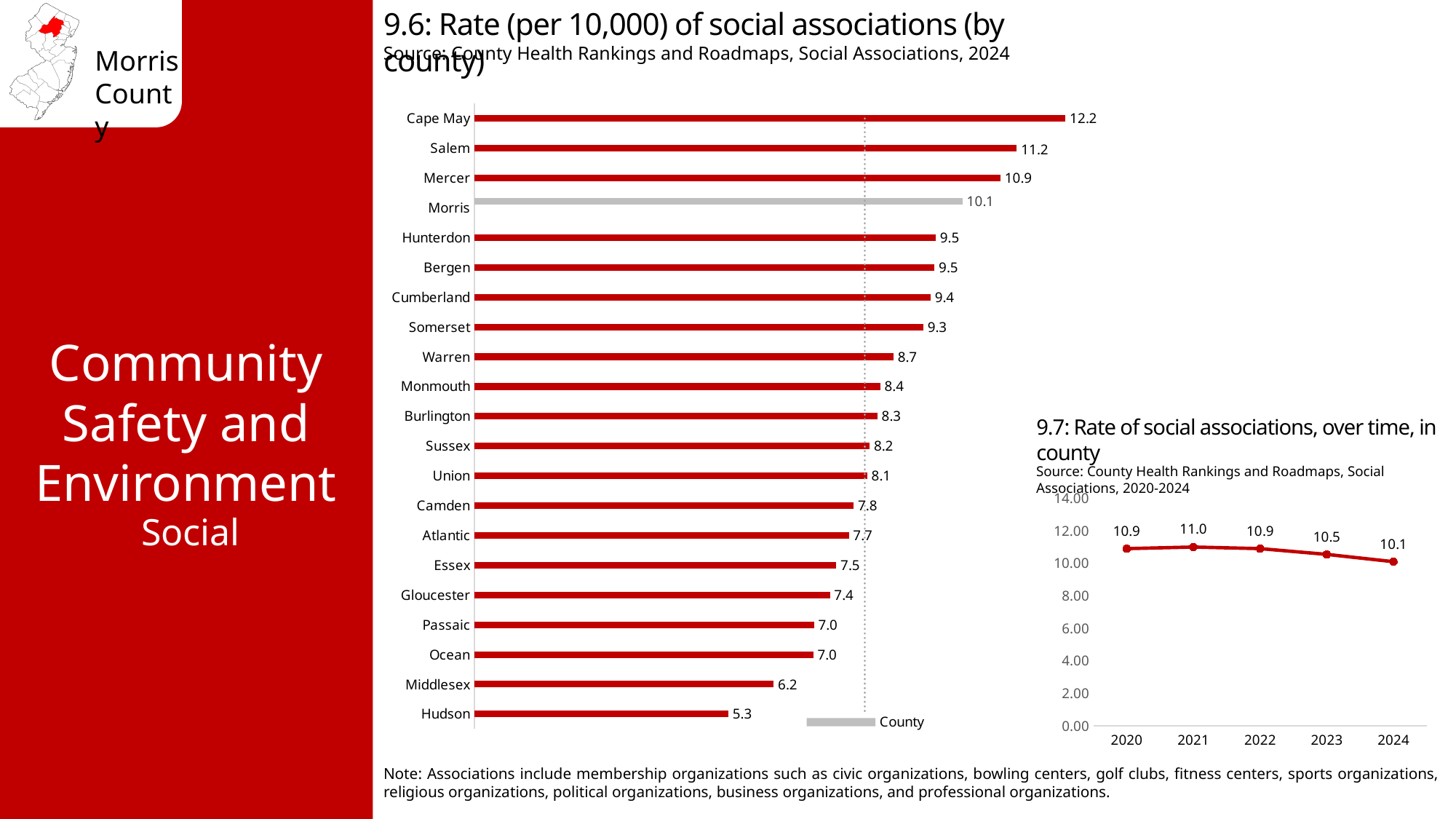
In the chart 9.7 (rate of social associations over time), how many years are plotted? 5 In the chart 9.6 (rate of social associations by county), what is the difference between Cape May and Hudson? 6.9 What kind of chart is chart 9.6 (rate of social associations by county)? Bar chart In the chart 9.6 (rate of social associations by county), how many counties are shown? 21 In the chart 9.6 (rate of social associations by county), what is the value for Middlesex? 6.2 In the chart 9.6 (rate of social associations by county), what is the value for Morris? 10.1 In the chart 9.7 (rate of social associations over time), do the values rise or fall from 2022 to 2024? Fall In the chart 9.6 (rate of social associations by county), which county has the highest rate? Cape May In the chart 9.6 (rate of social associations by county), which has a higher rate, Salem or Mercer? Salem In the chart 9.7 (rate of social associations over time), what is the value for 2021? 11.0 In the chart 9.6 (rate of social associations by county), which county has the lowest rate? Hudson In the chart 9.7 (rate of social associations over time), what is the difference between 2020 and 2024? 0.8